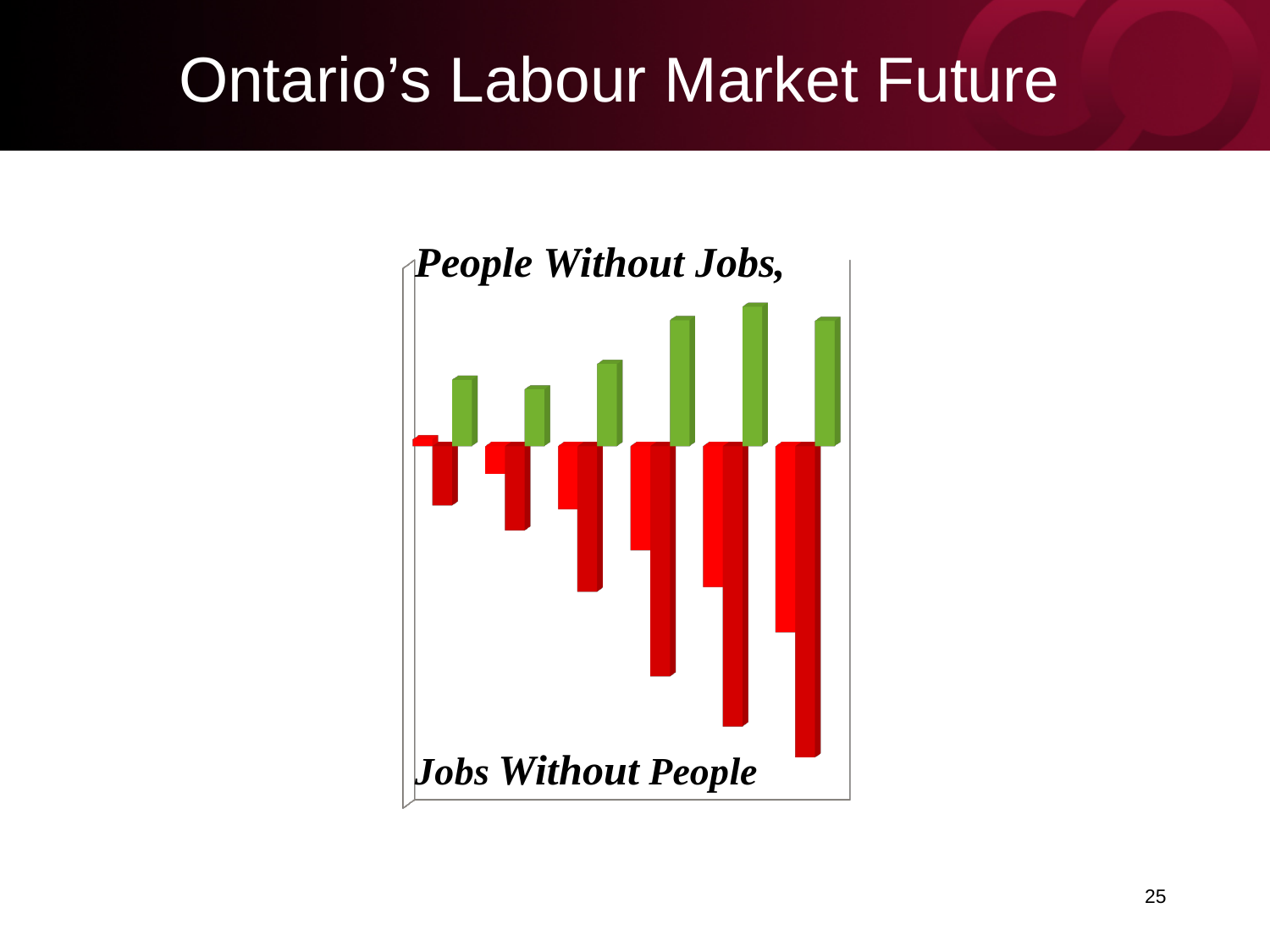
How many pairs of bars (categories) are plotted in the chart? 6 What text label appears at the bottom of the chart below the red bars? Jobs Without People Which position from the left has the longest red (downward) bar? the sixth (rightmost) What kind of chart is shown on the slide? bar chart What text label appears at the top of the chart above the green bars? People Without Jobs, How many red bars are plotted in the chart? 12 Do the red (downward) bars get longer or shorter moving from left to right? longer Is the green bar in the fourth position taller or shorter than the green bar in the first position? taller Which position from the left has the tallest green (upward) bar? the fifth Is the red bar in the third position longer or shorter than the red bar in the fifth position? shorter How many green bars are plotted in the chart? 6